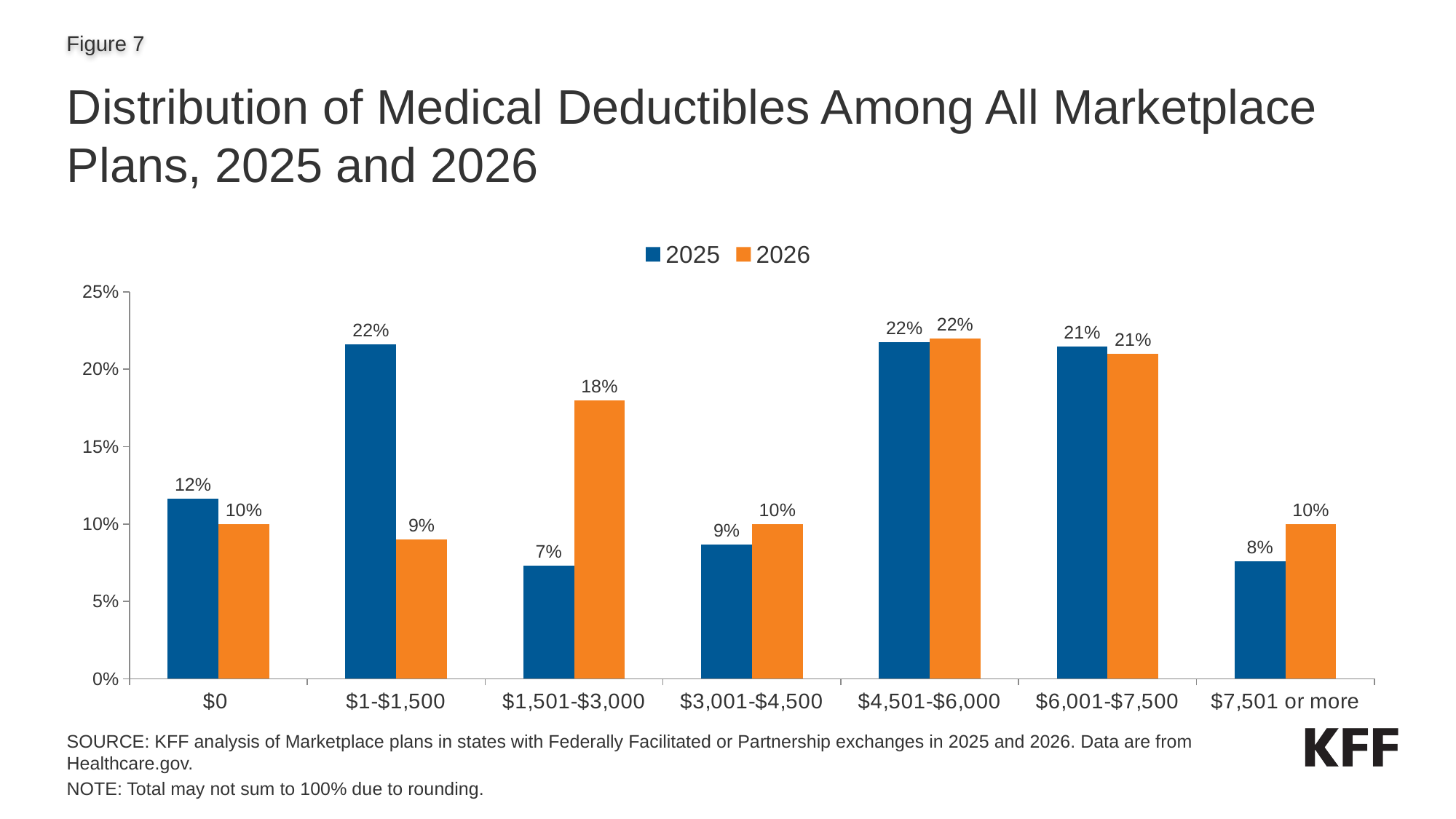
What is the difference between the 2025 and 2026 values for the $1-$1,500 category? 13 percentage points What is the 2026 value for the $1,501-$3,000 deductible category? 18% How many deductible categories are shown on the x axis? 7 How many series does the legend list? 2 What is the 2025 value for the $1-$1,500 deductible category? 22% For the $0 deductible category, which year has the larger value, 2025 or 2026? 2025 Which deductible category has the lowest 2025 value? $1,501-$3,000 What kind of chart is shown on the slide? Bar chart Which deductible category has the lowest 2026 value? $1-$1,500 What is the difference between the 2026 and 2025 values for the $1,501-$3,000 category? 11 percentage points What is the 2025 value for the $0 deductible category? 12% What is the 2026 value for the $7,501 or more deductible category? 10%